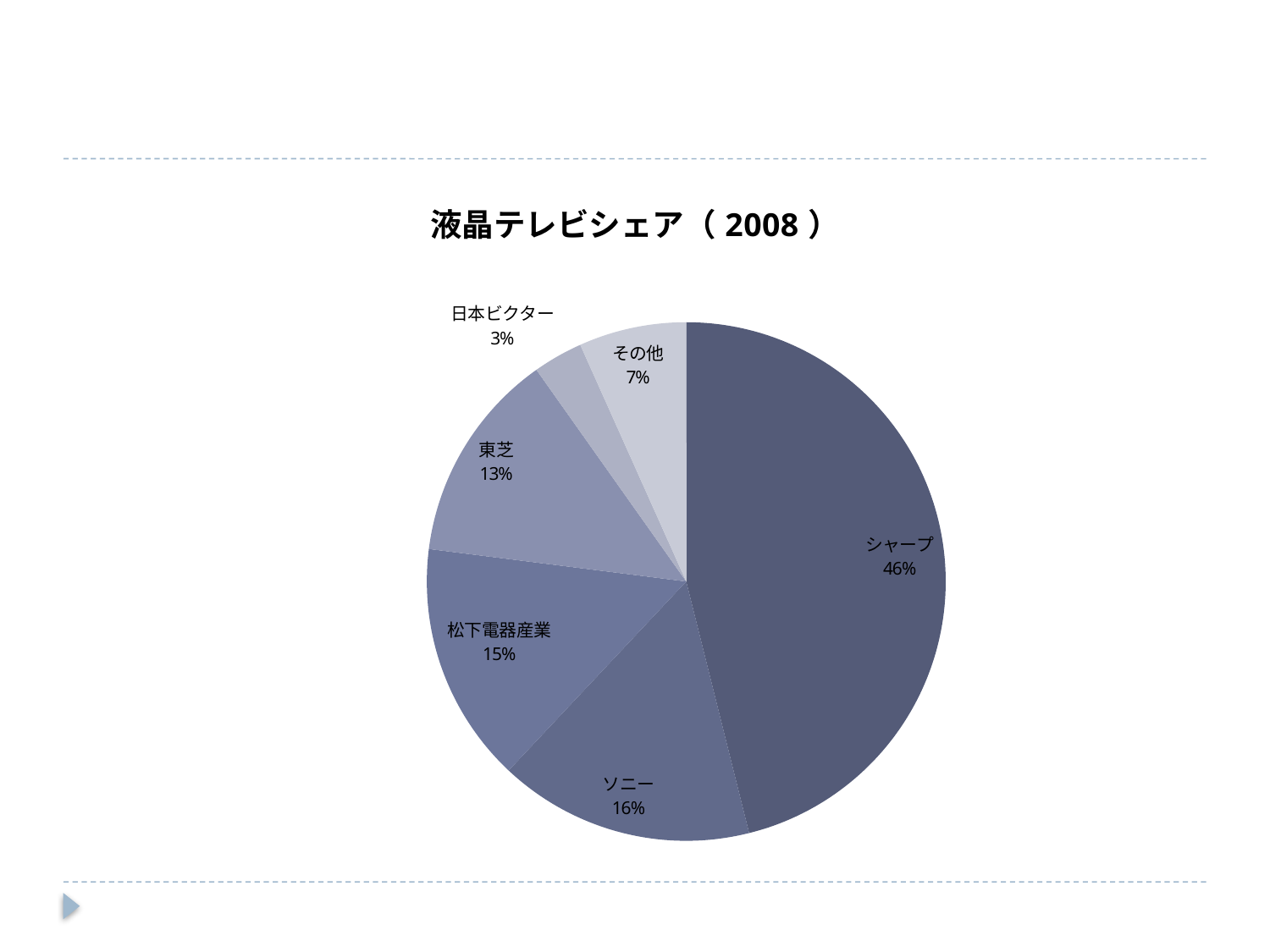
Which company has the largest share in the pie chart? シャープ What share does 日本ビクター have in the pie chart? 3% What kind of chart is shown on the slide? pie chart Which slice has the smallest share in the pie chart? 日本ビクター How many slices does the pie chart have? 6 What share does その他 have in the pie chart? 7% What share does 松下電器産業 have in the pie chart? 15% What is the title of the chart? 液晶テレビシェア（2008） What is the difference between the shares of シャープ and ソニー? 30%